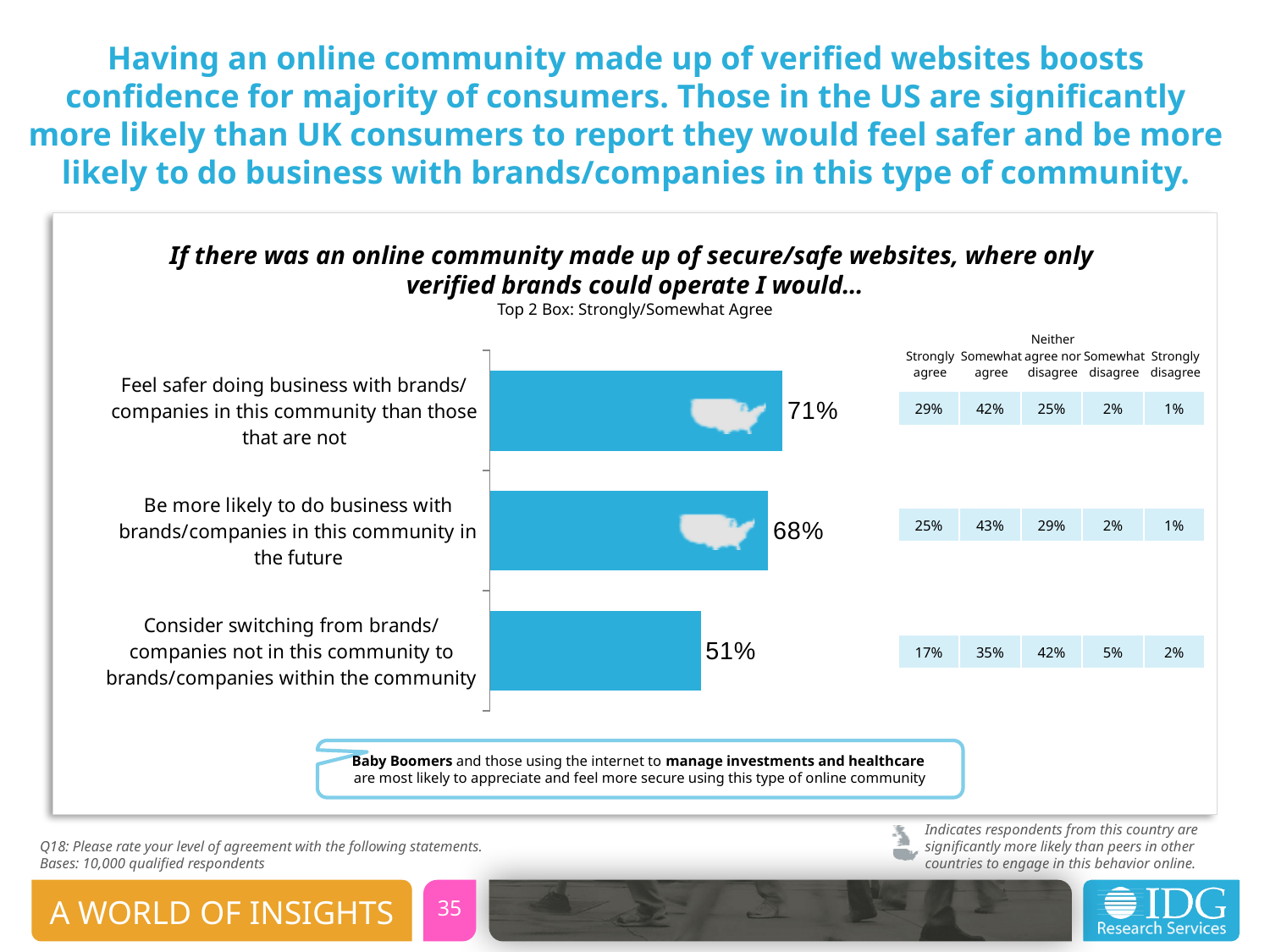
What is the Top 2 Box value for "Consider switching from brands/companies not in this community to brands/companies within the community"? 51% What is the difference in Top 2 Box agreement between "Feel safer doing business..." and "Consider switching from brands/companies..."? 20 percentage points Which statement has the highest Top 2 Box agreement? Feel safer doing business with brands/companies in this community than those that are not What is the Top 2 Box value for "Be more likely to do business with brands/companies in this community in the future"? 68% In the table to the right of the chart, what percentage strongly agree that they would feel safer doing business with brands/companies in this community? 29% What does the chart subtitle say the bars represent? Top 2 Box: Strongly/Somewhat Agree How many statements are plotted in the bar chart? 3 Which has a higher Top 2 Box value: "Be more likely to do business with brands/companies in this community in the future" or "Consider switching from brands/companies not in this community"? Be more likely to do business with brands/companies in this community in the future Which statement has the lowest Top 2 Box agreement? Consider switching from brands/companies not in this community to brands/companies within the community What is the difference in Top 2 Box agreement between "Feel safer doing business..." and "Be more likely to do business..."? 3 percentage points What type of chart is shown on the slide? Bar chart What is the Top 2 Box value for "Feel safer doing business with brands/companies in this community than those that are not"? 71%